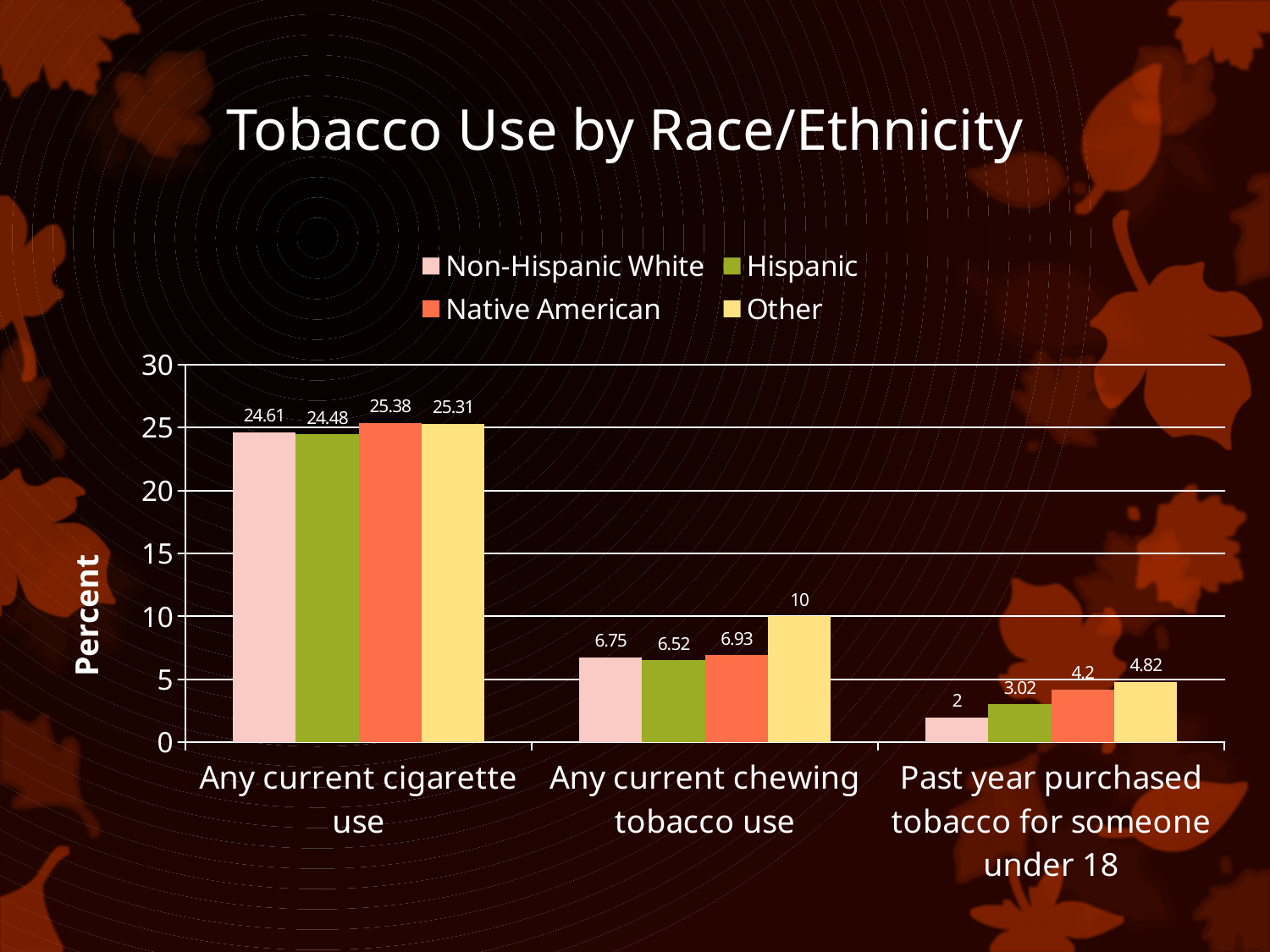
What is the value for Non-Hispanic White in the 'Past year purchased tobacco for someone under 18' category? 2 Which group has the lowest value for 'Past year purchased tobacco for someone under 18'? Non-Hispanic White How many series does the legend list? 4 What is the difference between the Other and Hispanic values for 'Any current chewing tobacco use'? 3.48 What is the label of the y axis? Percent Which group has the highest value for 'Any current chewing tobacco use'? Other What is the value for Native American in the 'Any current cigarette use' category? 25.38 What is the value for Other in the 'Any current chewing tobacco use' category? 10 What kind of chart is shown on the slide? bar chart How many categories are shown on the x axis? 3 Which is larger for 'Past year purchased tobacco for someone under 18': Hispanic or Other? Other Is the value for Hispanic in 'Any current cigarette use' greater or less than 20? greater